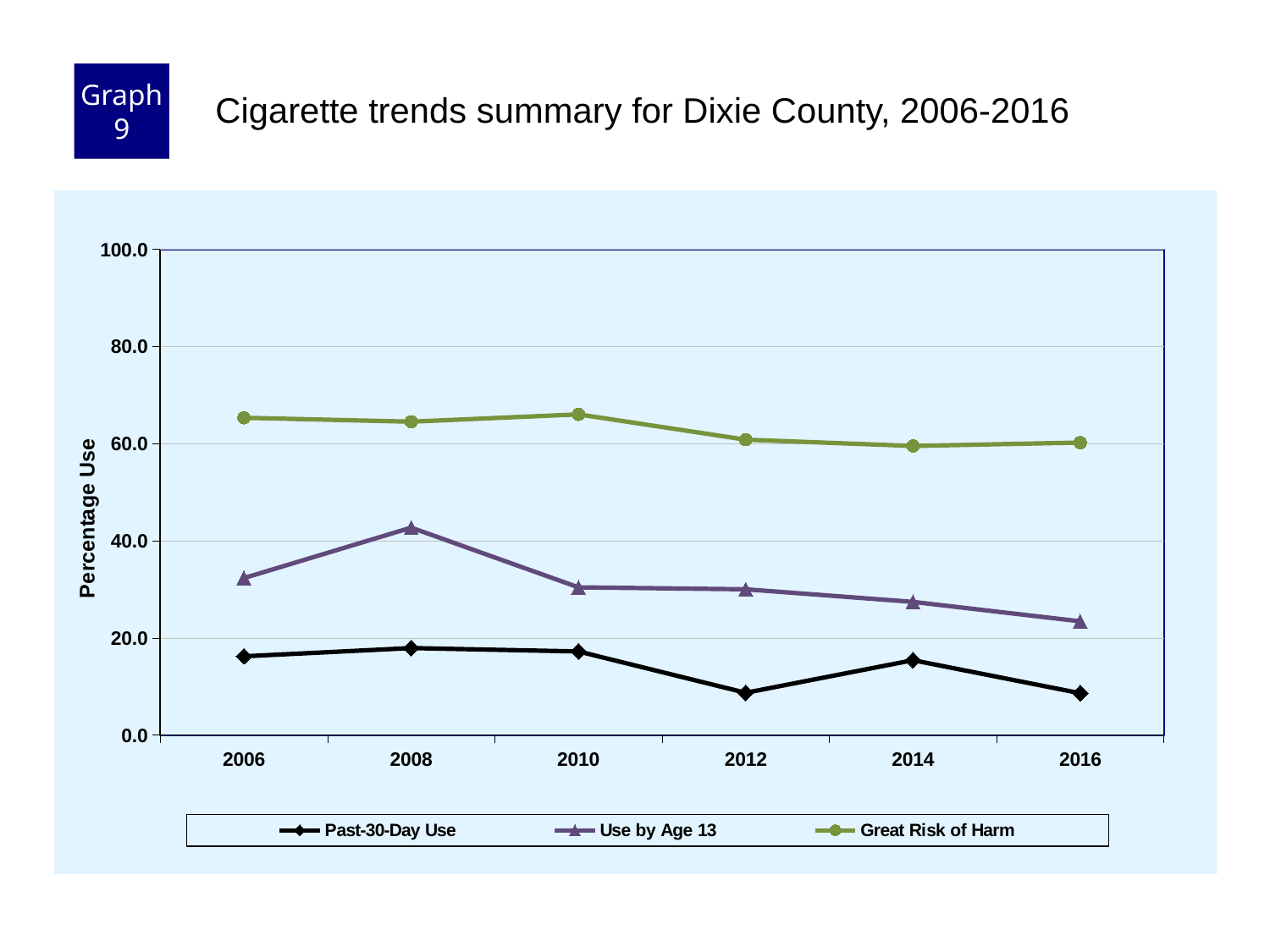
How many series does the legend list? 3 Which is larger for Use by Age 13: the value in 2008 or the value in 2016? 2008 Is the value for Use by Age 13 in 2008 greater or less than 40.0? greater What is the label on the vertical axis? Percentage Use Does the Use by Age 13 series rise or fall from 2008 to 2016? Fall What is the title of the chart? Cigarette trends summary for Dixie County, 2006-2016 Is the value for Use by Age 13 in 2016 greater or less than 20.0? greater How many years are plotted along the x axis? 6 In which year is Use by Age 13 at its highest? 2008 What kind of chart is shown on the slide? Line chart Is the value for Past-30-Day Use in 2012 greater or less than 20.0? less